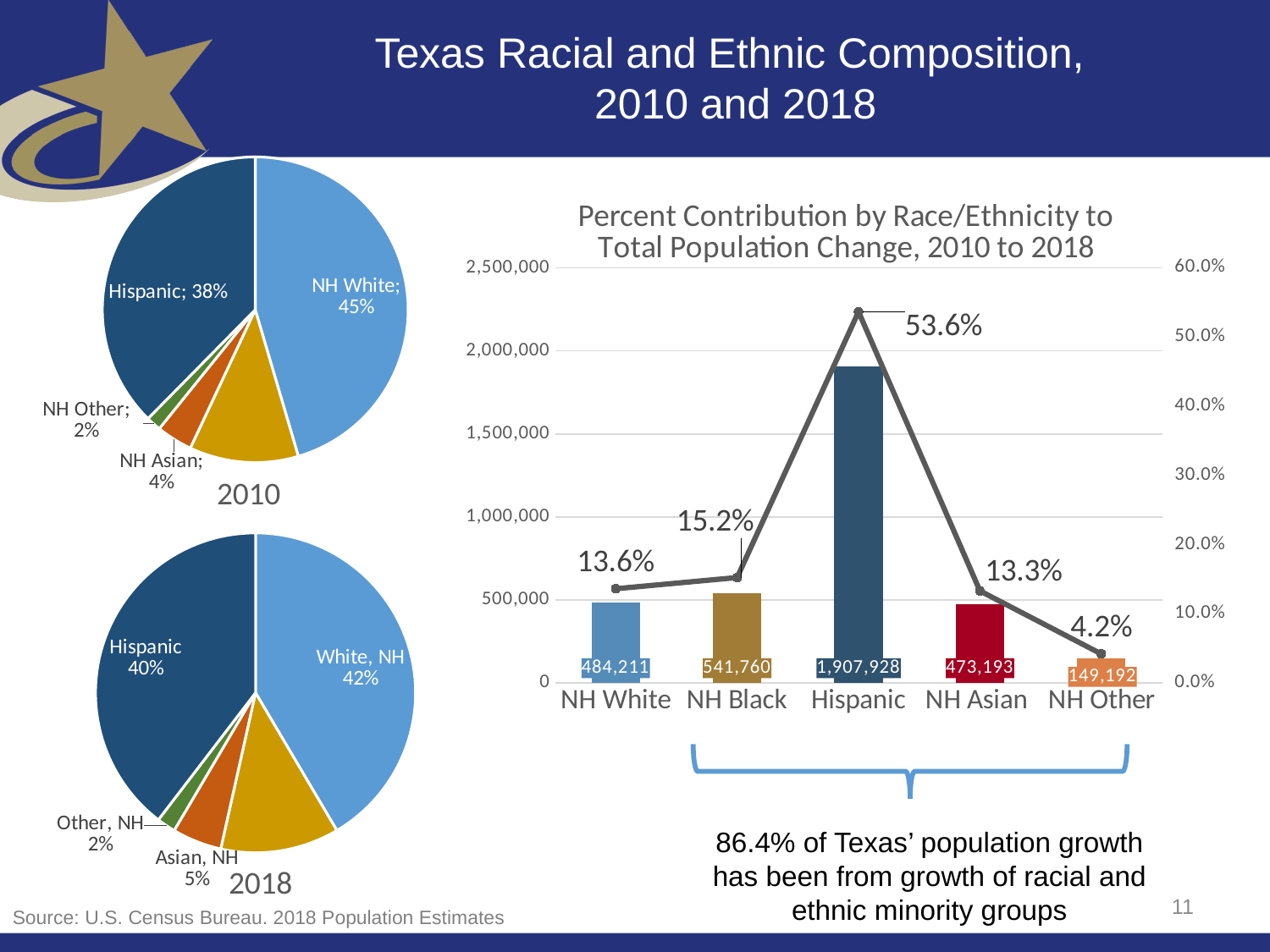
In the 2010 pie chart, what share of the population is NH Asian? 4% In the 'Percent Contribution by Race/Ethnicity to Total Population Change, 2010 to 2018' chart, what is the difference between the population change for NH Black and NH White? 57,549 In the 'Percent Contribution by Race/Ethnicity to Total Population Change, 2010 to 2018' chart, which category has the highest percent contribution? Hispanic In the 'Percent Contribution by Race/Ethnicity to Total Population Change, 2010 to 2018' chart, what is the population change value for Hispanic? 1,907,928 In the 'Percent Contribution by Race/Ethnicity to Total Population Change, 2010 to 2018' chart, what percent contribution is shown for NH Asian? 13.3% In the 2018 pie chart, what share of the population is Hispanic? 40% How many categories are shown on the x axis of the 'Percent Contribution by Race/Ethnicity to Total Population Change, 2010 to 2018' chart? 5 In the 'Percent Contribution by Race/Ethnicity to Total Population Change, 2010 to 2018' chart, which category has the lowest population change? NH Other In the 'Percent Contribution by Race/Ethnicity to Total Population Change, 2010 to 2018' chart, what is the population change value for NH Black? 541,760 In the 2010 pie chart, what share of the population is NH White? 45% In the 'Percent Contribution by Race/Ethnicity to Total Population Change, 2010 to 2018' chart, which is larger, the population change for NH White or NH Asian? NH White What kind of chart is used to show the 2010 and 2018 racial and ethnic composition on the left of the slide? Pie chart